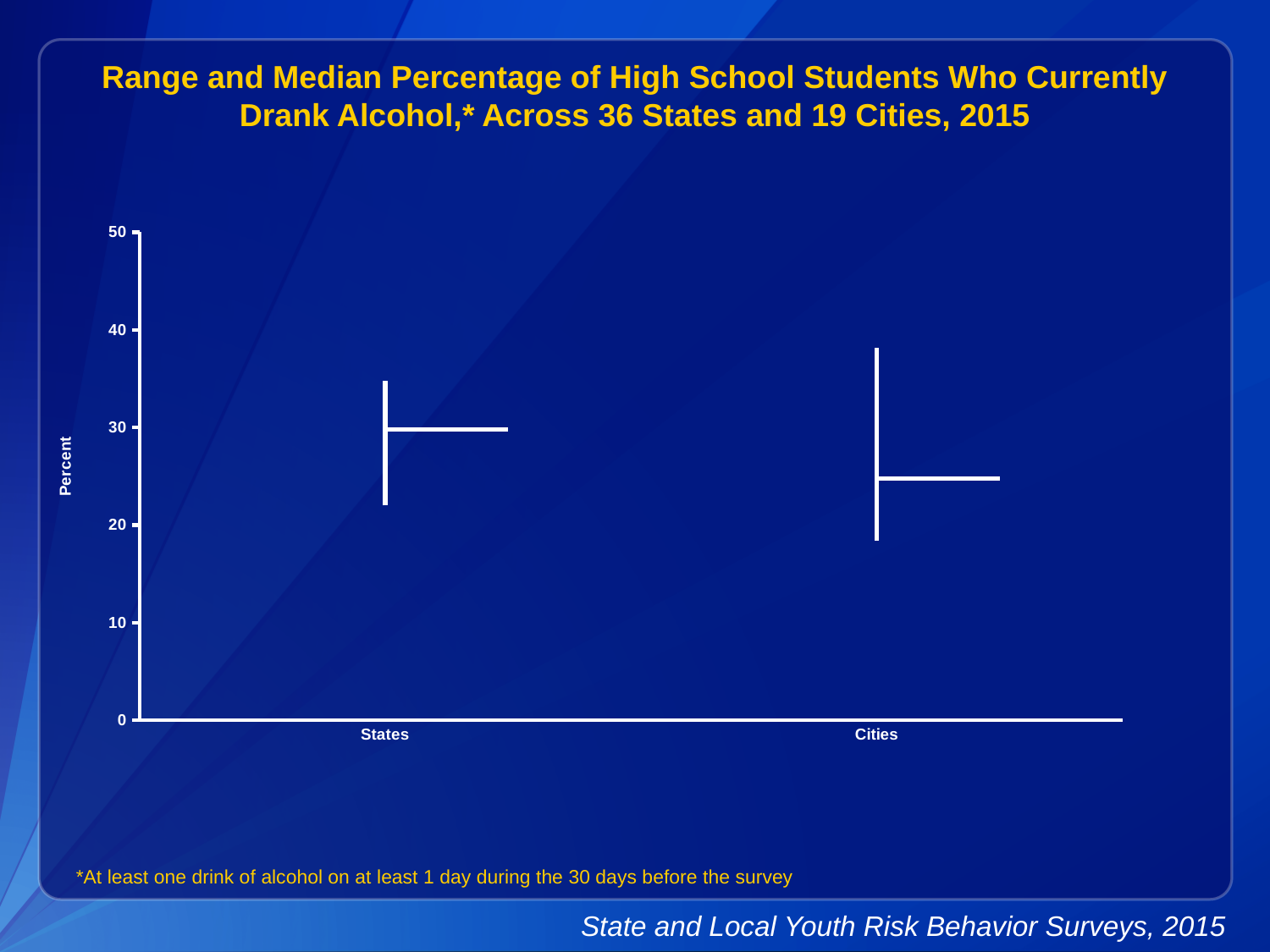
What is the label on the y axis of the chart? Percent Is the median value for States greater or less than 20? greater How many categories are shown on the x axis of the chart? 2 Which category has the higher median percentage, States or Cities? States Is the median value for Cities greater or less than 30? less Which category shows the wider range of percentages, States or Cities? Cities Is the top of the range for States greater or less than 30? greater Which category has the lower median percentage? Cities What are the two categories shown on the x axis? States and Cities